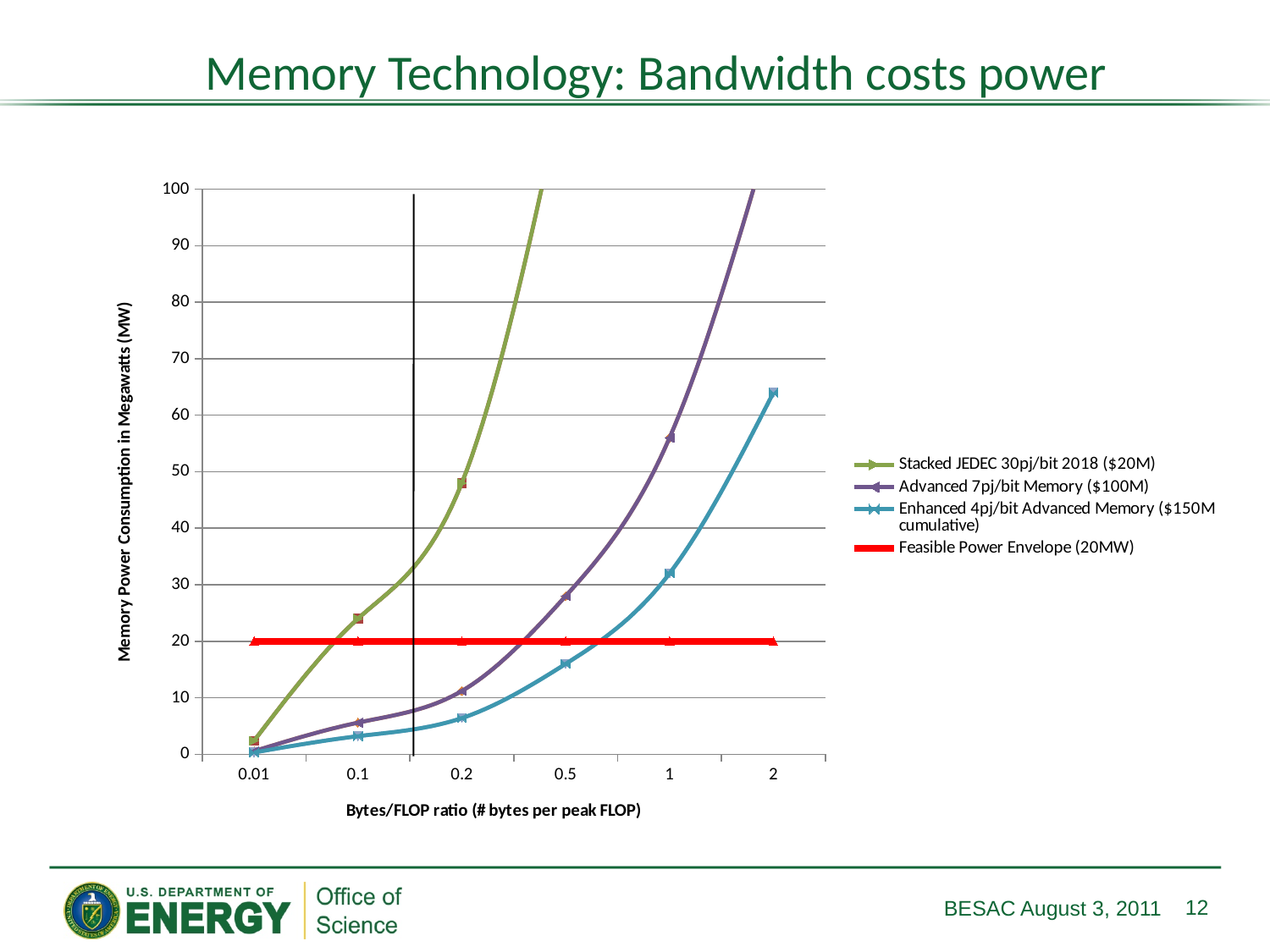
How many Bytes/FLOP ratio values are labelled on the x axis? 6 What kind of chart is shown on the slide? line chart Which series reaches the highest memory power consumption at a Bytes/FLOP ratio of 0.2? Stacked JEDEC 30pj/bit 2018 ($20M) Is the value for Advanced 7pj/bit Memory ($100M) at a Bytes/FLOP ratio of 1 greater or less than 50? greater How many series does the legend list? 4 What is the value of the Feasible Power Envelope series across the chart? 20 Does the Stacked JEDEC 30pj/bit 2018 ($20M) series rise or fall as the Bytes/FLOP ratio increases? rise What is the title of the y axis? Memory Power Consumption in Megawatts (MW) At a Bytes/FLOP ratio of 0.5, which series is higher: Advanced 7pj/bit Memory ($100M) or Enhanced 4pj/bit Advanced Memory ($150M cumulative)? Advanced 7pj/bit Memory ($100M) Is the value for Enhanced 4pj/bit Advanced Memory ($150M cumulative) at a Bytes/FLOP ratio of 0.5 greater or less than 20? less Is the value for Stacked JEDEC 30pj/bit 2018 ($20M) at a Bytes/FLOP ratio of 0.2 greater or less than 40? greater